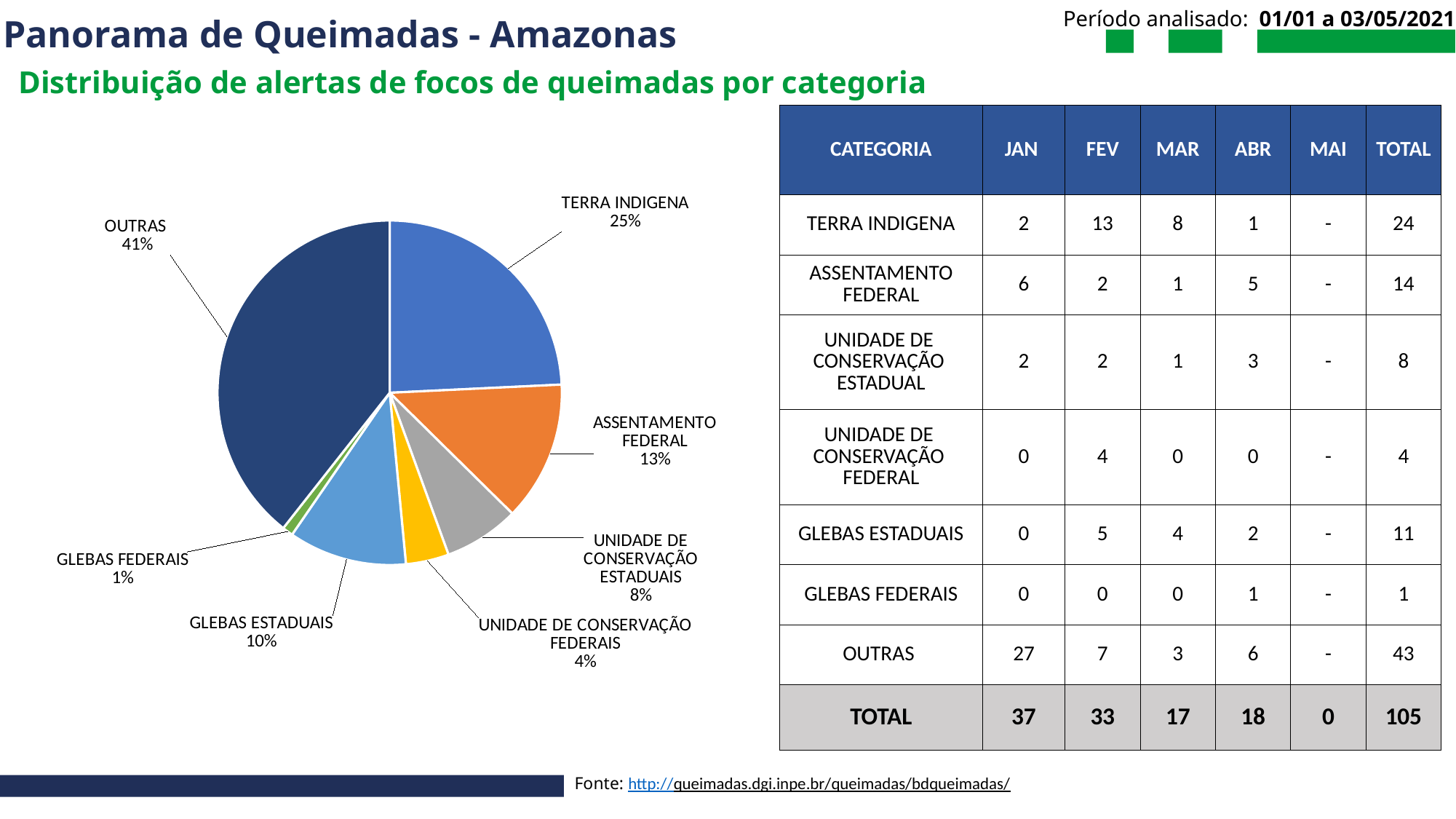
Which slice is larger in the pie chart, GLEBAS ESTADUAIS or UNIDADE DE CONSERVAÇÃO ESTADUAIS? GLEBAS ESTADUAIS Which category has the smallest slice in the pie chart? GLEBAS FEDERAIS What is the title shown above the pie chart? Distribuição de alertas de focos de queimadas por categoria What is the difference in percentage points between OUTRAS and TERRA INDIGENA in the pie chart? 16 What percentage is shown for GLEBAS ESTADUAIS in the pie chart? 10% What share of the pie chart does OUTRAS represent? 41% What percentage is shown for UNIDADE DE CONSERVAÇÃO FEDERAIS in the pie chart? 4% What type of chart is shown on the slide? Pie chart Which category has the largest slice in the pie chart? OUTRAS What share of the pie chart does TERRA INDIGENA represent? 25% What percentage is shown for ASSENTAMENTO FEDERAL in the pie chart? 13% How many slices does the pie chart have? 7